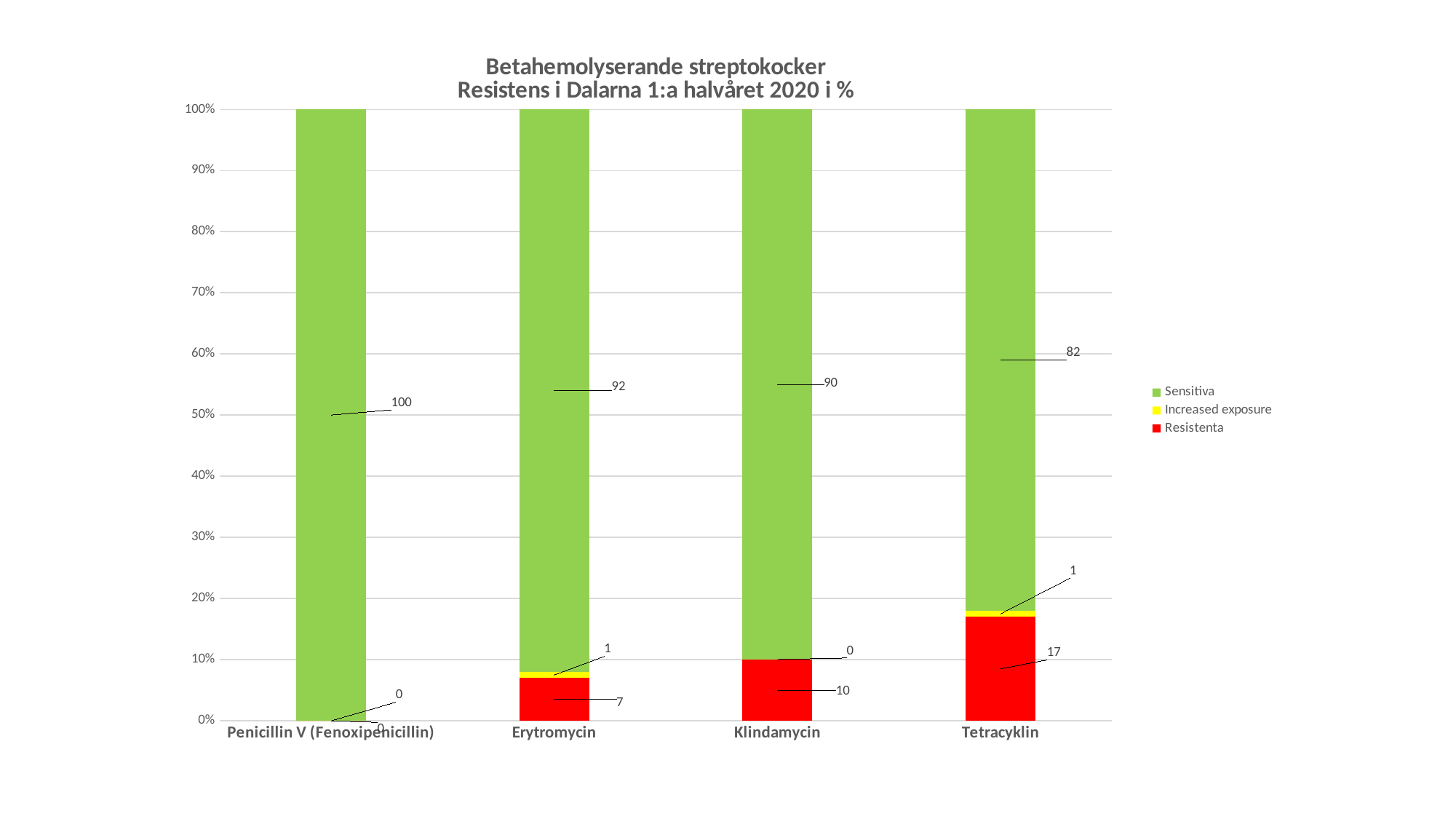
How many series does the legend list? 3 Which antibiotic has the lowest Sensitiva value? Tetracyklin What is the Sensitiva value for Penicillin V (Fenoxipenicillin)? 100 What is the Increased exposure value for Klindamycin? 0 What is the Sensitiva value for Erytromycin? 92 What is the Resistenta value for Tetracyklin? 17 What is the difference between the Resistenta values for Tetracyklin and Klindamycin? 7 Which antibiotic has the highest Resistenta value? Tetracyklin How many antibiotics are shown on the x axis? 4 Which is larger, the Sensitiva value for Erytromycin or for Klindamycin? Erytromycin What kind of chart is shown on the slide? Stacked bar chart Which colour represents the Resistenta series? Red